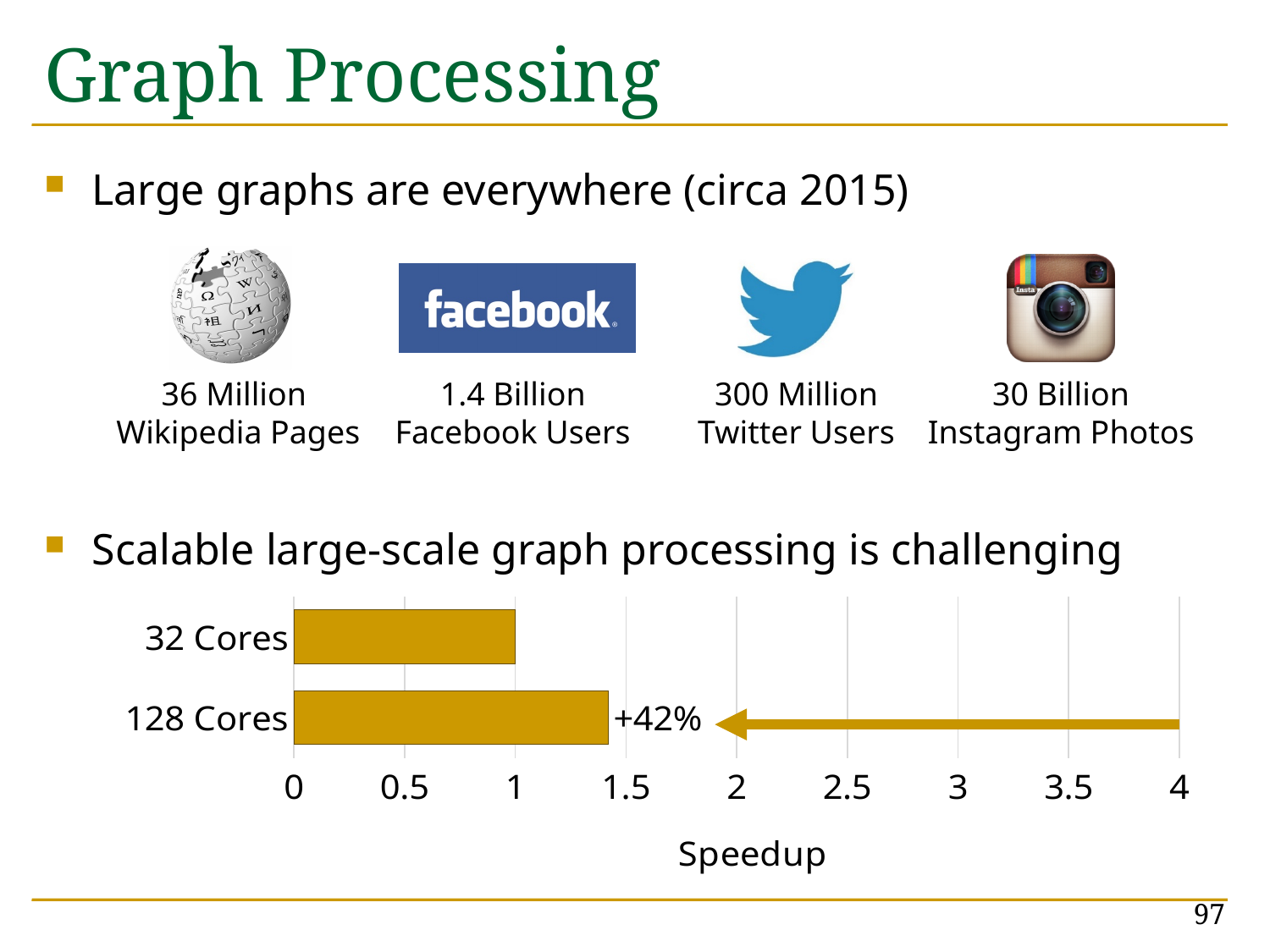
How many categories are plotted in the chart? 2 Is the speedup for 128 Cores greater or less than 1.5? less Is the speedup for 32 Cores greater or less than 1.5? less Is the speedup for 128 Cores greater or less than 1? greater Which category has the highest speedup? 128 Cores What is the label of the x axis of the chart? Speedup Which category has the lowest speedup? 32 Cores What annotation is printed next to the 128 Cores bar? +42% What is the speedup value for 32 Cores? 1 What kind of chart is shown on the slide? bar chart Which has a larger speedup, 32 Cores or 128 Cores? 128 Cores